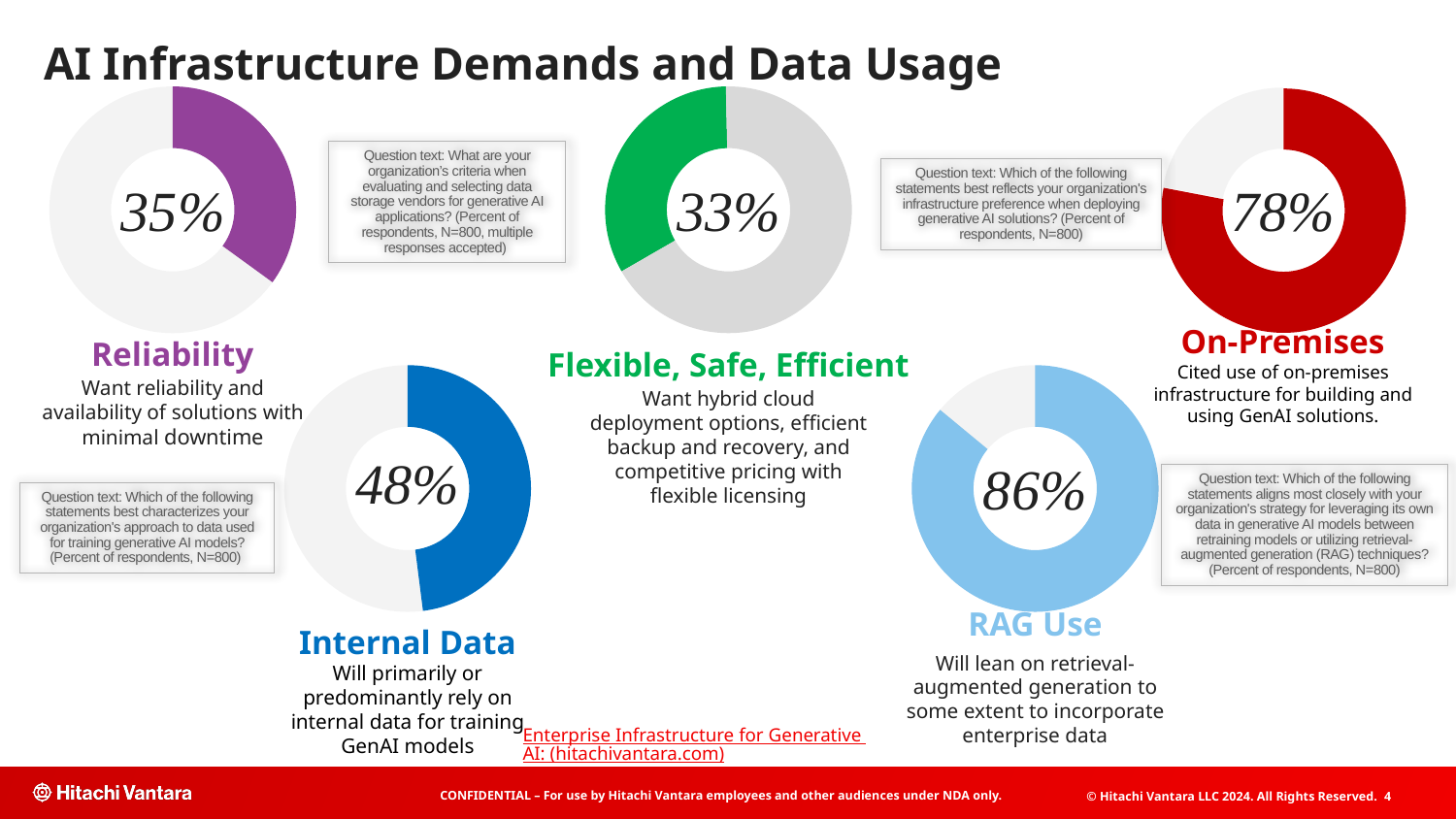
What percentage is shown in the Flexible, Safe, Efficient donut chart? 33% What percentage is shown in the Reliability donut chart? 35% What is the difference between the On-Premises percentage and the Internal Data percentage? 30% How many donut charts are shown on the slide? 5 Which of the donut charts on the slide shows the highest percentage? RAG Use Which of the donut charts on the slide shows the lowest percentage? Flexible, Safe, Efficient What colour is the filled segment of the On-Premises donut chart? Red What percentage is shown in the RAG Use donut chart? 86% What percentage is shown in the Internal Data donut chart? 48% Which is larger, the Reliability percentage or the Flexible, Safe, Efficient percentage? Reliability What type of chart is used to show the Reliability percentage? Donut chart What percentage is shown in the On-Premises donut chart? 78%